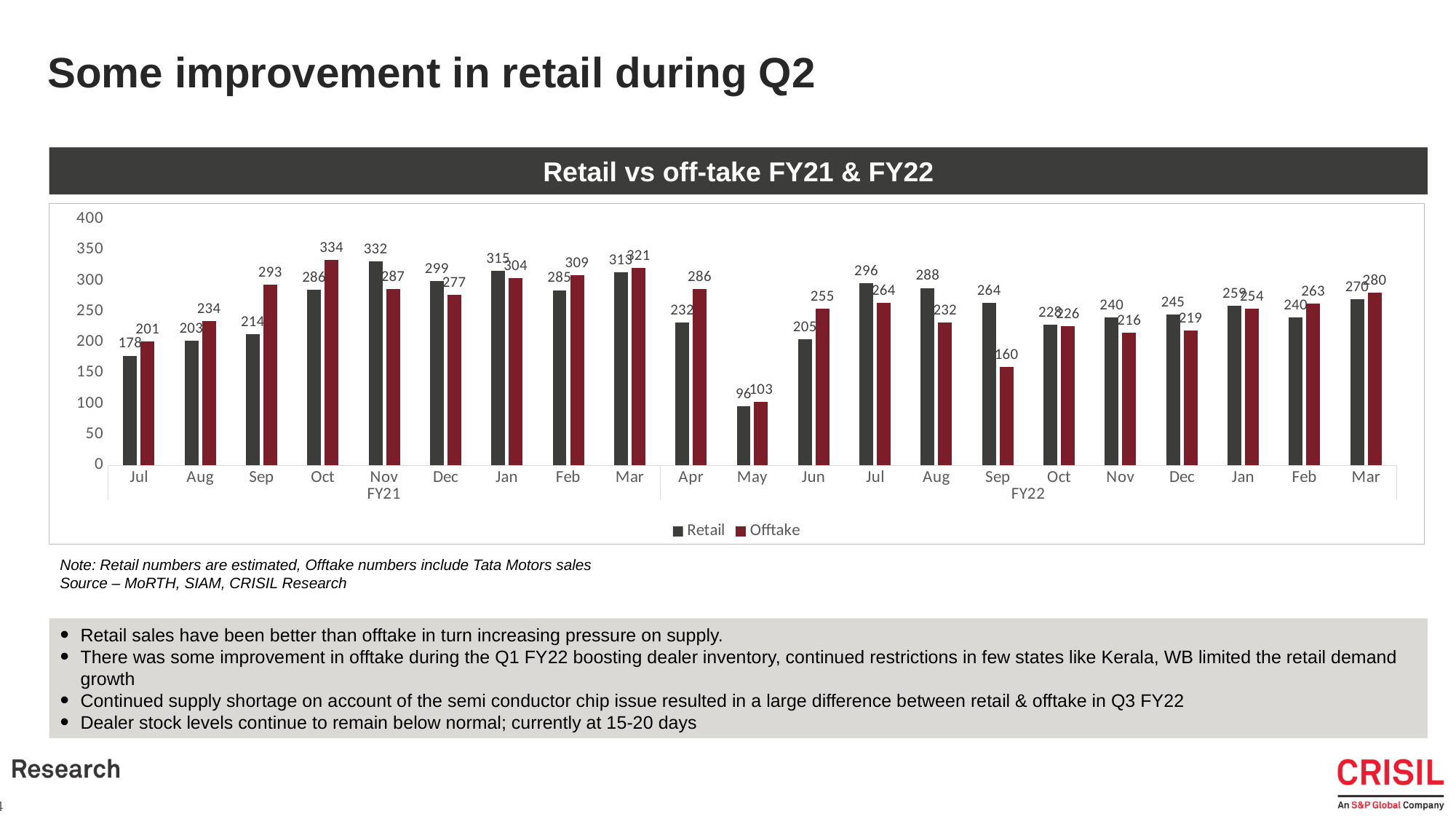
What is the Retail value for May FY22? 96 What is the difference between Retail and Offtake in Sep FY22? 104 What is the title of the chart? Retail vs off-take FY21 & FY22 In Apr FY22, which is larger, Retail or Offtake? Offtake How many months are plotted on the x axis? 21 What type of chart is shown on the slide? Bar chart How many series does the legend list? 2 What is the Retail value for Sep FY22? 264 Is the Offtake value for Jun FY22 greater or less than 250? greater Which month has the highest Offtake value? Oct FY21 What is the Offtake value for Oct FY21? 334 Which month has the lowest Retail value? May FY22